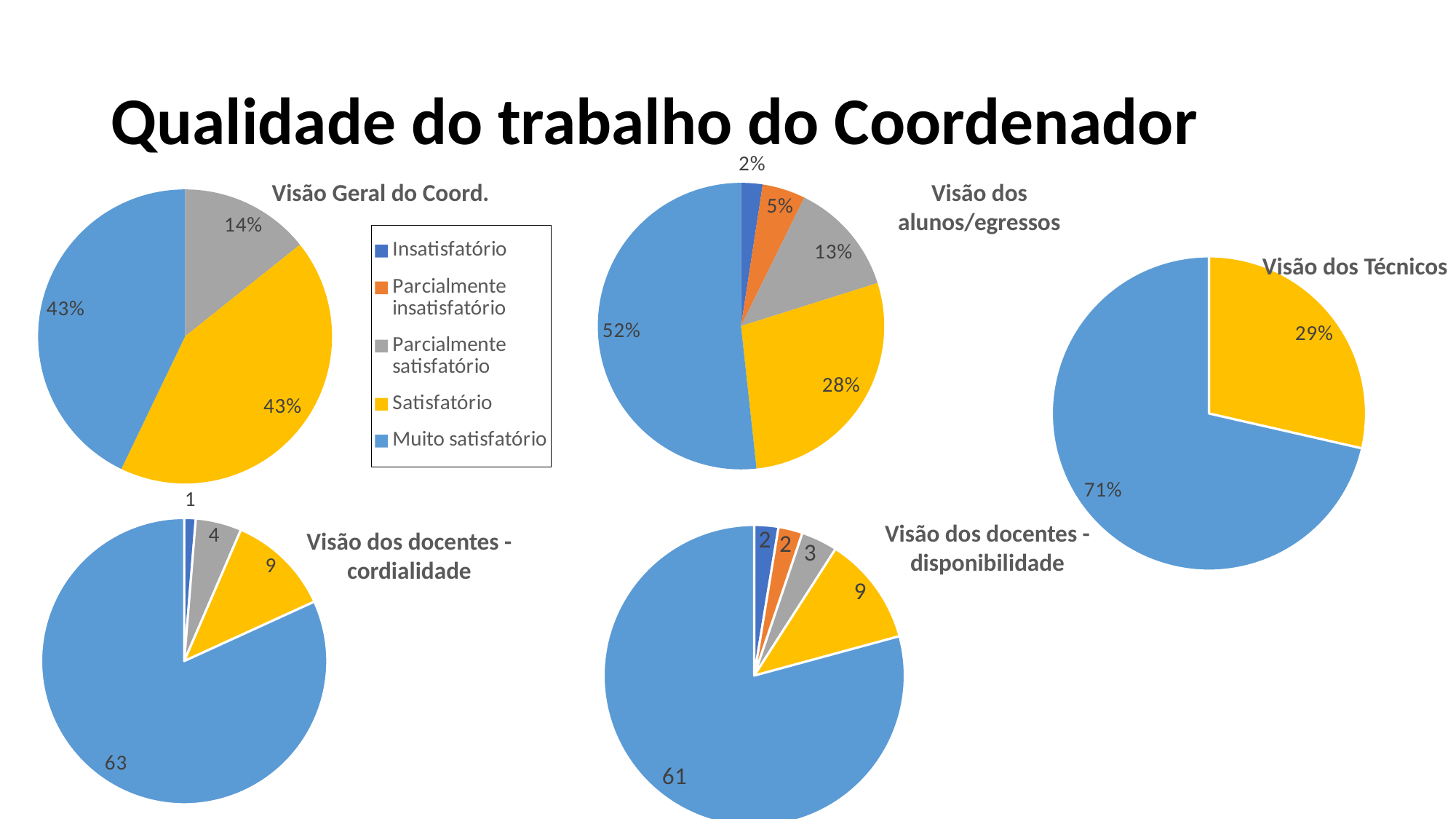
What type of chart is 'Visão dos Técnicos'? Pie chart How many slices does the 'Visão dos docentes - disponibilidade' chart have? 5 In the 'Visão dos Técnicos' chart, what percentage is shown for the Satisfatório slice? 29% In the 'Visão Geral do Coord.' chart, what percentage is shown for the Parcialmente satisfatório slice? 14% In the 'Visão dos alunos/egressos' chart, which is larger: the Satisfatório slice or the Parcialmente satisfatório slice? Satisfatório In the 'Visão dos docentes - cordialidade' chart, what value is shown for the Muito satisfatório slice? 63 In the 'Visão dos alunos/egressos' chart, which category has the smallest slice? Insatisfatório How many entries does the legend on the slide list? 5 In the 'Visão dos Técnicos' chart, what is the difference between the Muito satisfatório and Satisfatório percentages? 42% In the 'Visão dos docentes - disponibilidade' chart, which category has the largest slice? Muito satisfatório In the 'Visão dos docentes - disponibilidade' chart, what value is shown for the Satisfatório slice? 9 In the 'Visão dos alunos/egressos' chart, what percentage is shown for the Muito satisfatório slice? 52%